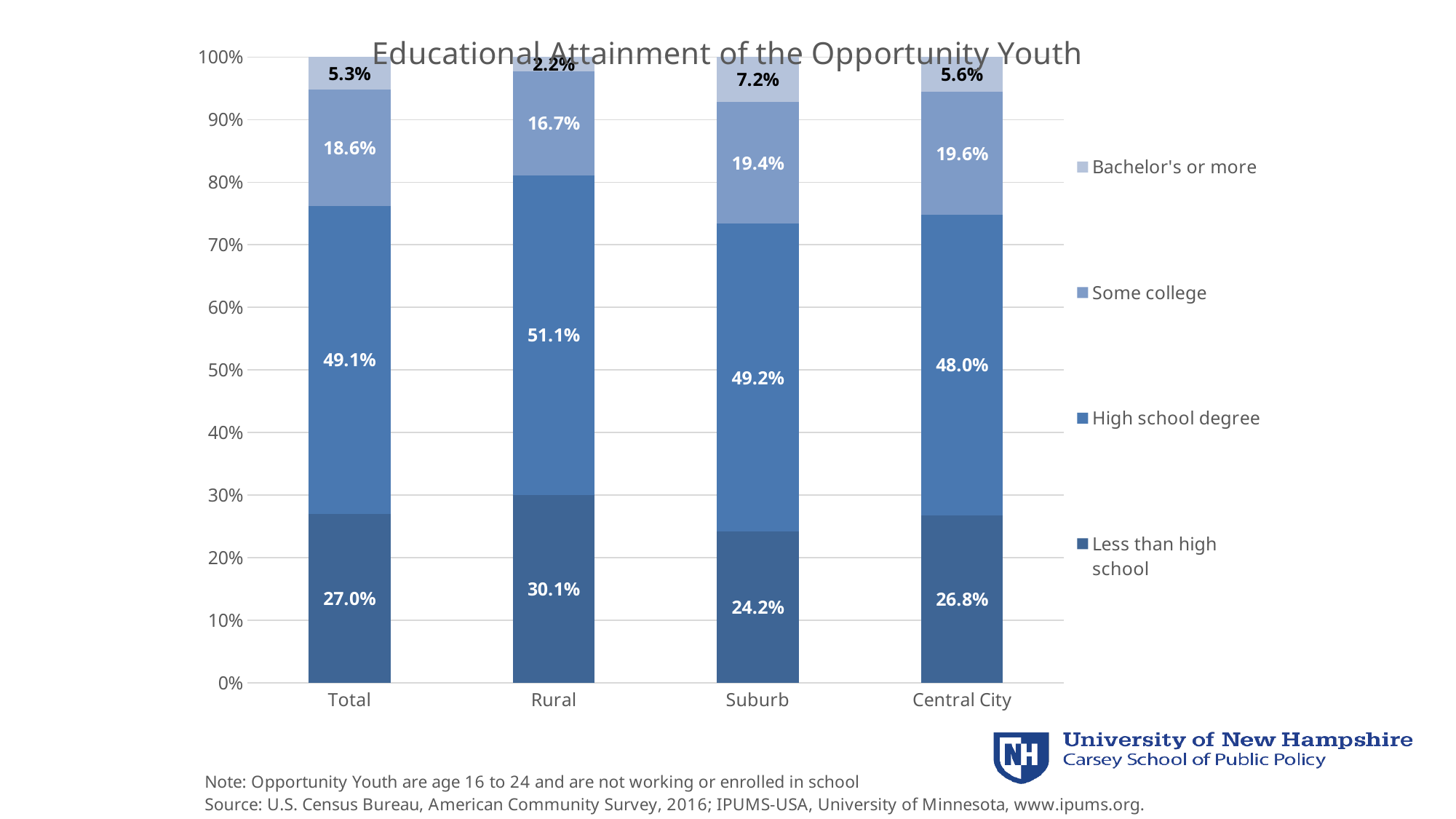
What kind of chart is shown on the slide? Stacked bar chart What is the High school degree value for Total? 49.1% What is the Bachelor's or more share for Suburb? 7.2% What is the title of the chart? Educational Attainment of the Opportunity Youth What is the difference between the Some college values for Total and Rural? 1.9% Which is larger, the High school degree share for Rural or for Central City? Rural Which category has the highest Less than high school share? Rural What percentage of Rural opportunity youth have less than a high school education? 30.1% How many categories are shown on the x axis? 4 What is the Some college value for Central City? 19.6% How many series does the legend list? 4 Which category has the lowest Bachelor's or more share? Rural